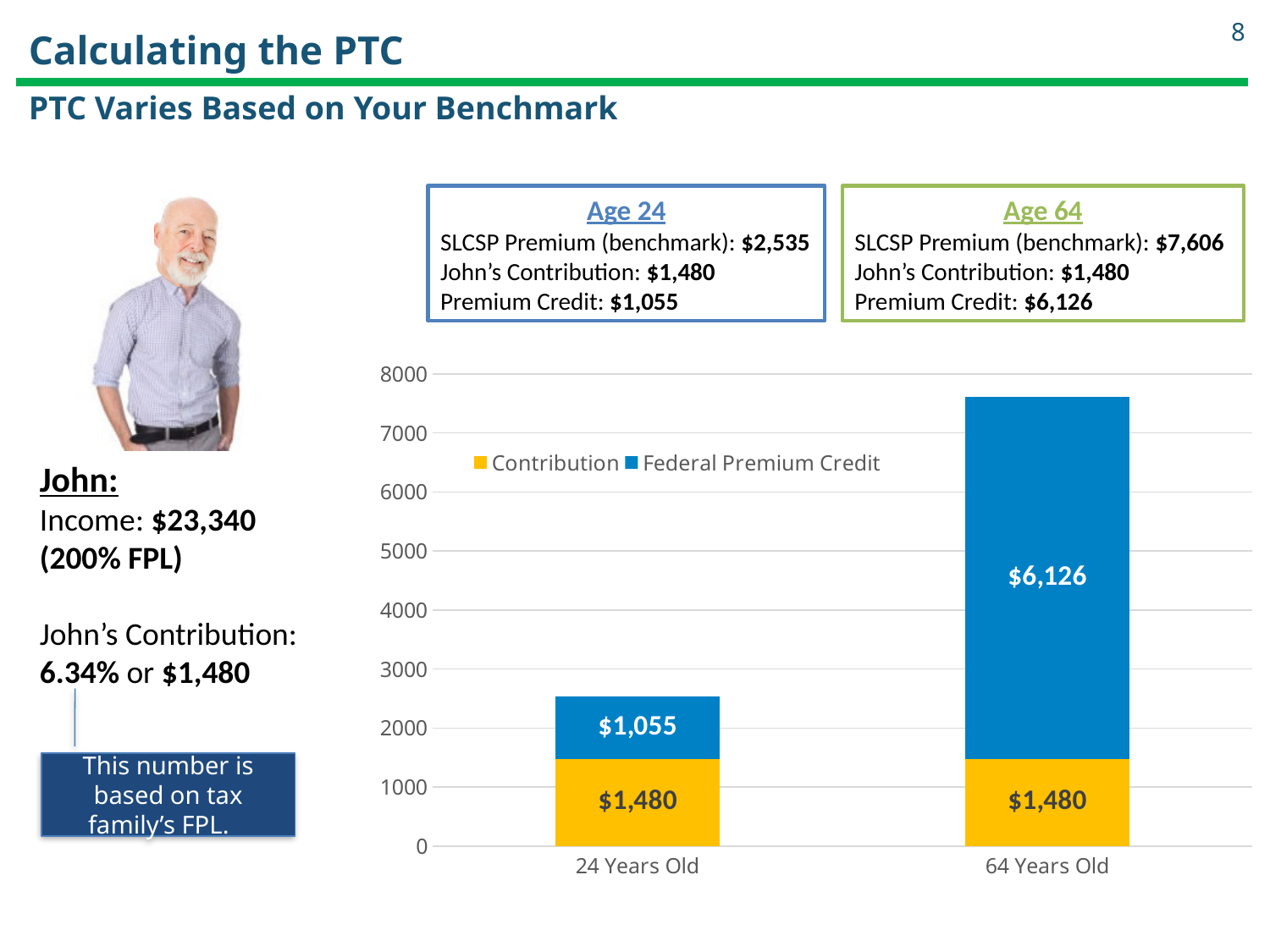
What is the total of the stacked bar for 64 Years Old? $7,606 Is the Federal Premium Credit for 64 Years Old larger or smaller than the Federal Premium Credit for 24 Years Old? larger Which age category has the higher Federal Premium Credit? 64 Years Old What is the difference in Federal Premium Credit between the 64 Years Old and 24 Years Old bars? $5,071 What is the Contribution value for the 24 Years Old bar? $1,480 Is the total height of the 64 Years Old bar greater or less than 7000? greater How many age categories are shown on the x axis? 2 How many series does the legend list? 2 What is the Federal Premium Credit value for the 64 Years Old bar? $6,126 What kind of chart is shown on the slide? Stacked bar chart What is the Federal Premium Credit value for the 24 Years Old bar? $1,055 What is the total of the stacked bar for 24 Years Old? $2,535